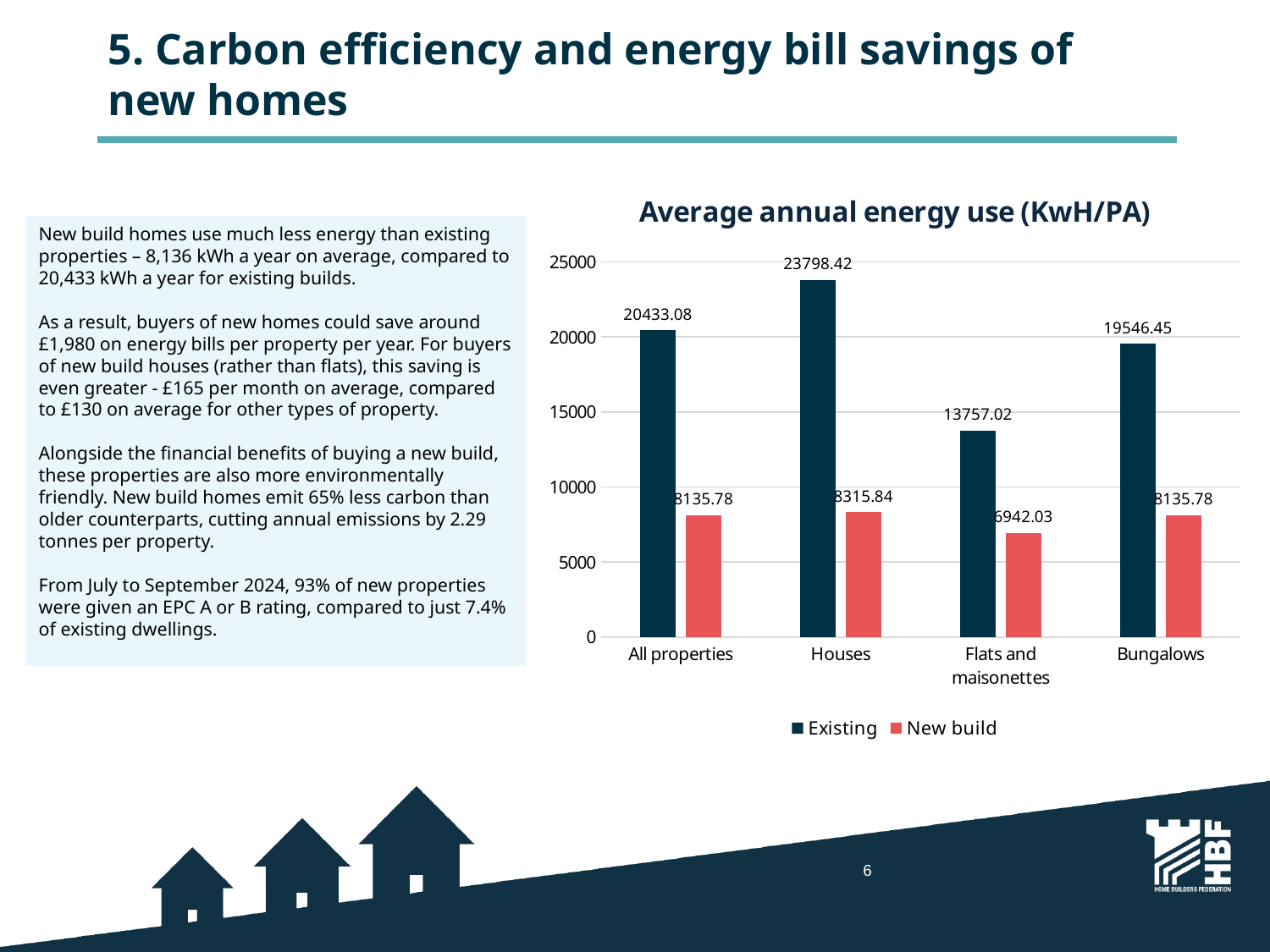
What kind of chart is shown on the slide? Bar chart What is the New build value for Flats and maisonettes? 6942.03 What is the difference between the Existing and New build values for Flats and maisonettes? 6814.99 What is the Existing value for Bungalows? 19546.45 What is the difference between the Existing and New build values for Houses? 15482.58 Which is larger, the Existing value for All properties or the Existing value for Bungalows? All properties How many series does the legend list? 2 What is the New build value for All properties? 8135.78 Which category has the highest Existing value? Houses How many categories are shown on the x axis? 4 Which category has the lowest New build value? Flats and maisonettes What is the Existing value for Houses? 23798.42